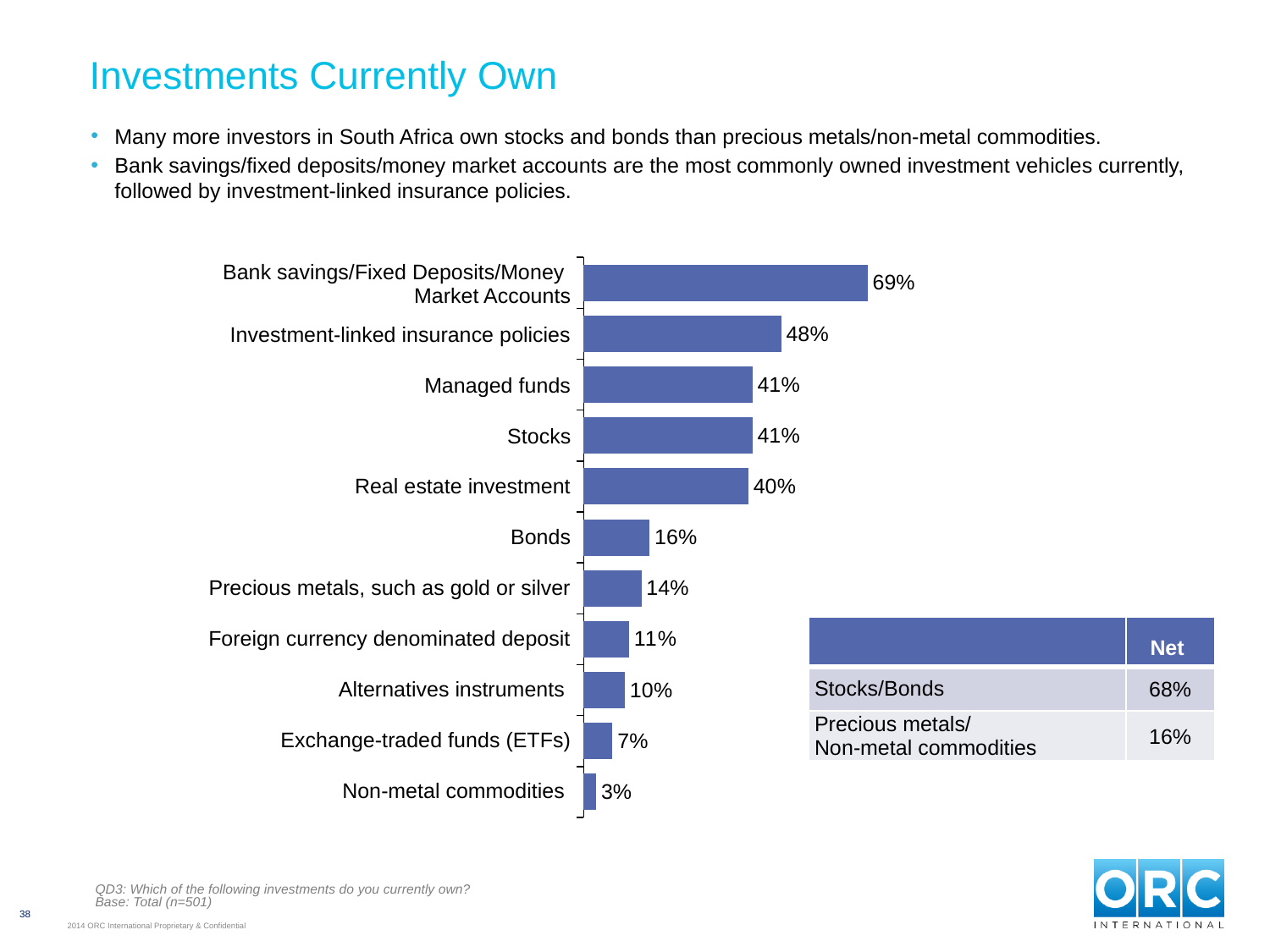
Which investment category has the lowest value in the chart? Non-metal commodities What type of chart is used to show the investments currently owned? Bar chart How many investment categories are shown in the bar chart? 11 What is the value for Exchange-traded funds (ETFs)? 7% Which has a larger value, Precious metals, such as gold or silver, or Foreign currency denominated deposit? Precious metals, such as gold or silver What percentage is shown for Real estate investment? 40% What is the difference between the values for Stocks and Bonds? 25% What percentage of investors currently own Bank savings/Fixed Deposits/Money Market Accounts? 69% Which investment category has the highest value in the chart? Bank savings/Fixed Deposits/Money Market Accounts What is the value shown for Investment-linked insurance policies? 48% What is the difference between the values for Bank savings/Fixed Deposits/Money Market Accounts and Investment-linked insurance policies? 21% In the Net table, what is the value for Stocks/Bonds? 68%